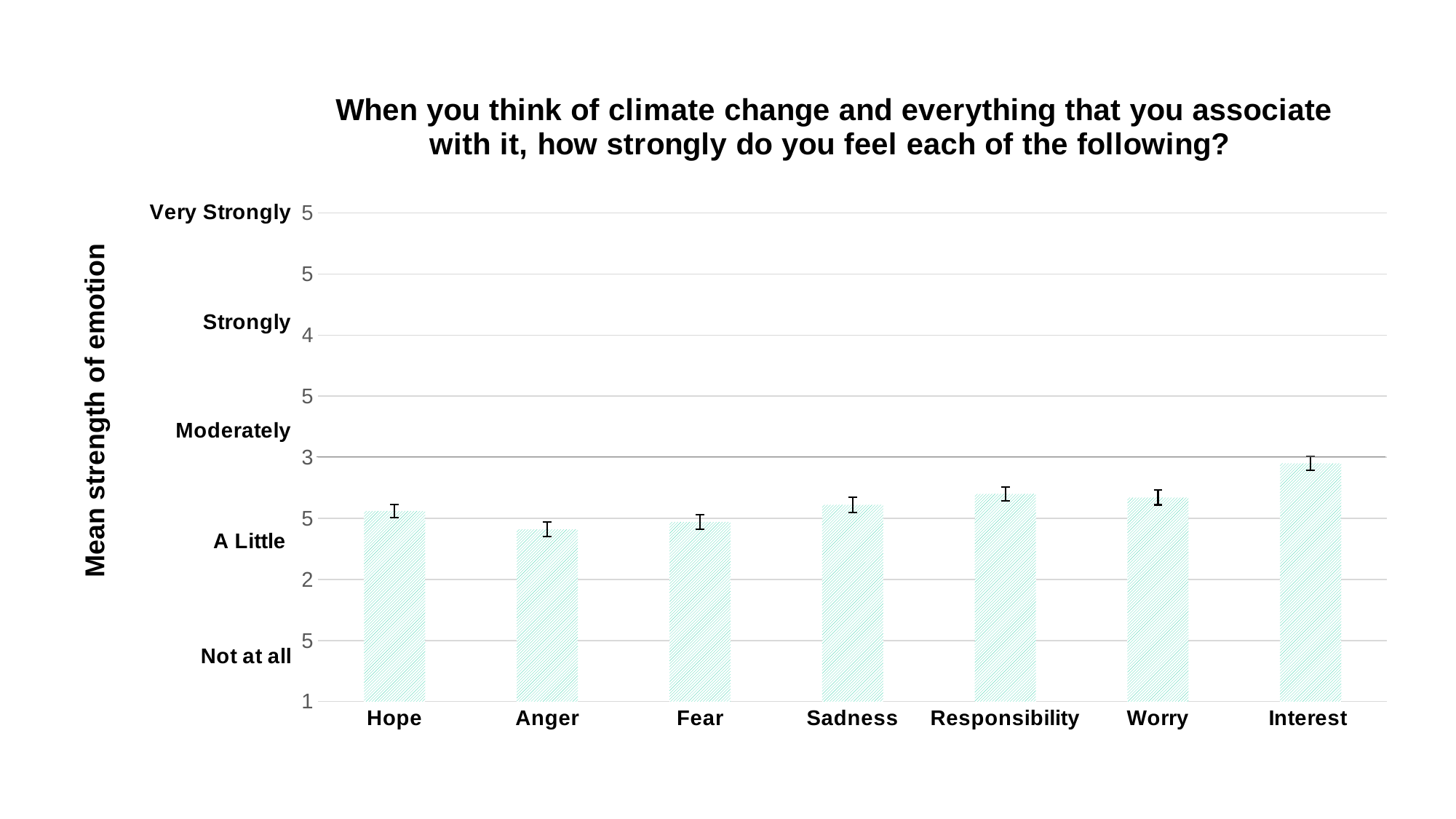
Which has a higher mean strength, Interest or Anger? Interest What is the label of the y axis? Mean strength of emotion Is the value for Interest greater or less than 2? greater How many emotions are plotted on the x axis? 7 Which emotion has the highest mean strength? Interest Is the value for Anger greater or less than 2.5? less Is the value for Worry greater or less than 3? less Which verbal label on the y axis corresponds to the value 5? Very Strongly Which emotion has the lowest mean strength? Anger What kind of chart is shown on the slide? bar chart Which has a higher mean strength, Responsibility or Fear? Responsibility